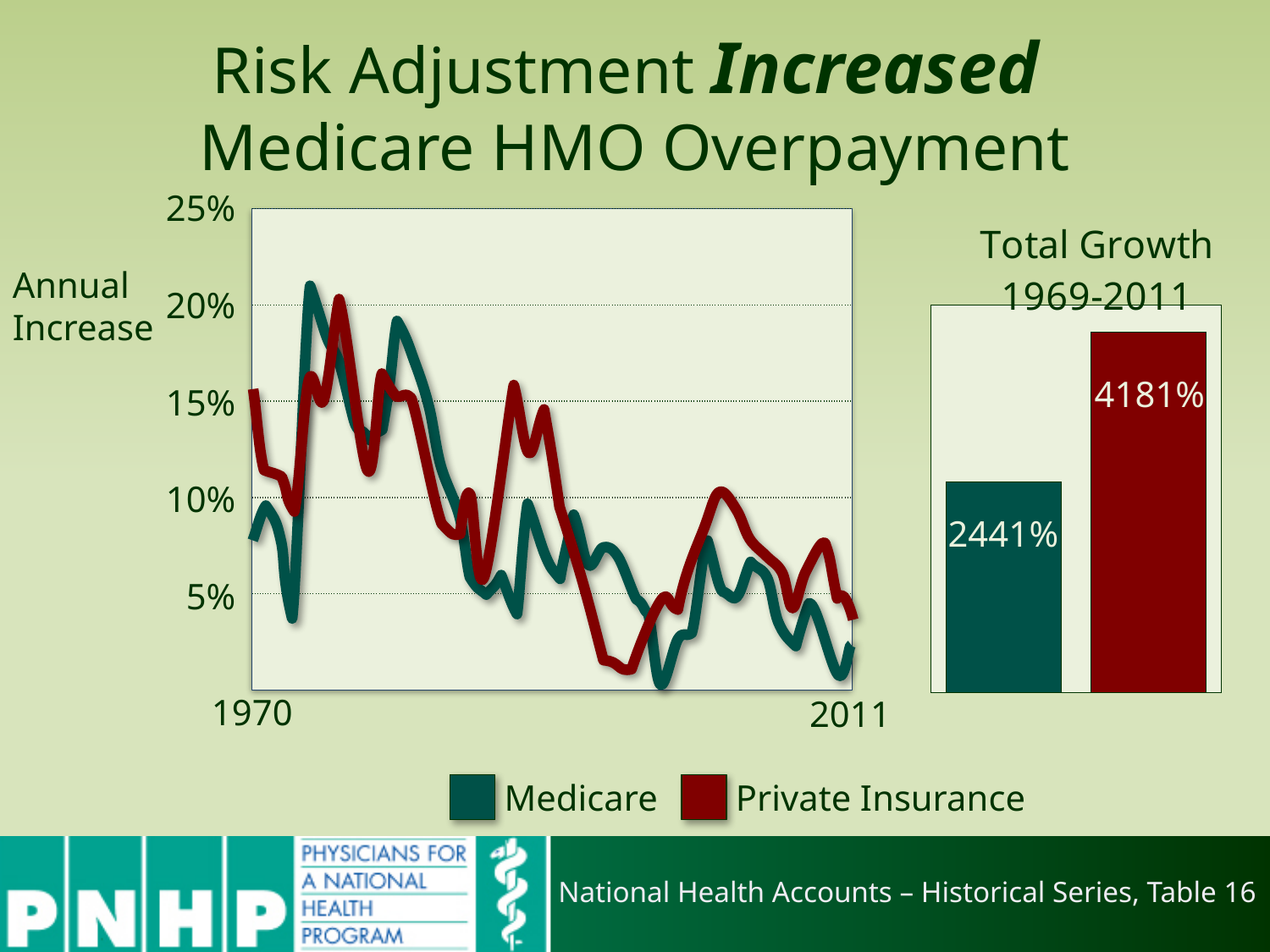
In the Total Growth 1969-2011 bar chart, what is the difference between the Private Insurance and Medicare values? 1740% In the Total Growth 1969-2011 bar chart, what is the value for Private Insurance? 4181% In the Annual Increase line chart, is the value for Medicare in 2011 greater or less than 5%? less In the Total Growth 1969-2011 bar chart, which series has the higher total growth? Private Insurance In the Total Growth 1969-2011 bar chart, which series has the lower total growth? Medicare What kind of chart is the Annual Increase chart on the left? line chart What kind of chart is the Total Growth 1969-2011 chart on the right? bar chart In the Annual Increase line chart, do the annual increase values generally rise or fall from 1970 to 2011? fall In the Total Growth 1969-2011 chart, is the Medicare value larger or smaller than the Private Insurance value? smaller How many series does the legend list? 2 In the Annual Increase line chart, is the peak value for Medicare in the early 1970s greater or less than 20%? greater In the Total Growth 1969-2011 bar chart, what is the value for Medicare? 2441%